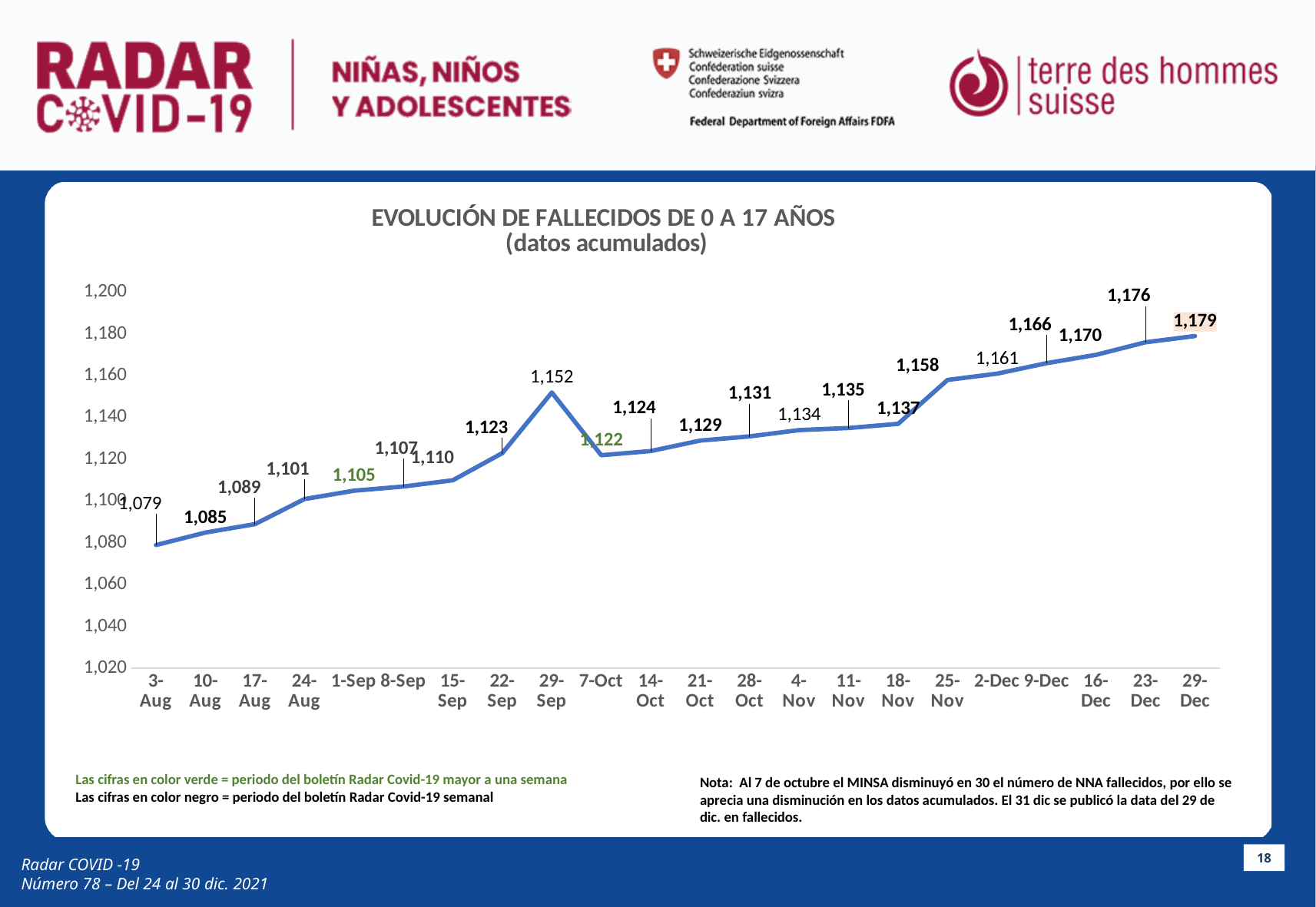
What is the cumulative value for 29-Sep? 1,152 What type of chart is shown on the slide? line chart How many data points are plotted on the line? 22 What is the difference between the values for 29-Dec and 3-Aug? 100 Which date has the lowest cumulative value? 3-Aug What is the cumulative value for 7-Oct? 1,122 What is the difference between the values for 29-Sep and 7-Oct? 30 What is the cumulative value for 29-Dec? 1,179 What is the title of the chart? EVOLUCIÓN DE FALLECIDOS DE 0 A 17 AÑOS (datos acumulados) Which is larger, the value for 29-Sep or the value for 14-Oct? 29-Sep Which date has the highest cumulative value? 29-Dec What is the cumulative value for 3-Aug? 1,079